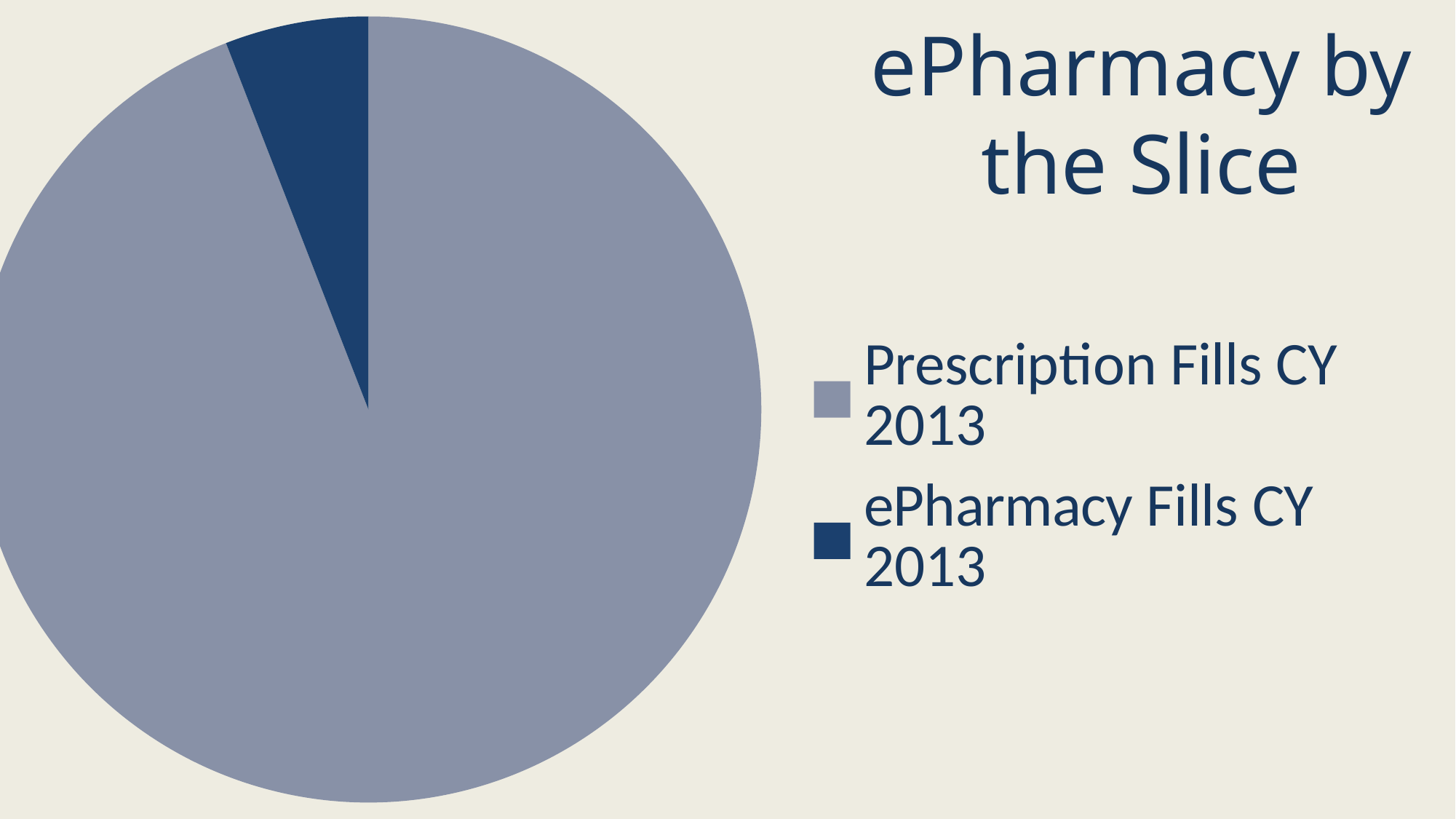
How many entries does the legend list? 2 What is the title of the chart? ePharmacy by the Slice Which legend entry is shown in dark blue? ePharmacy Fills CY 2013 Which slice is the largest? Prescription Fills CY 2013 How many slices does the pie chart have? 2 Which is larger, the Prescription Fills CY 2013 slice or the ePharmacy Fills CY 2013 slice? Prescription Fills CY 2013 What kind of chart is shown on the slide? pie chart Which slice is the smallest? ePharmacy Fills CY 2013